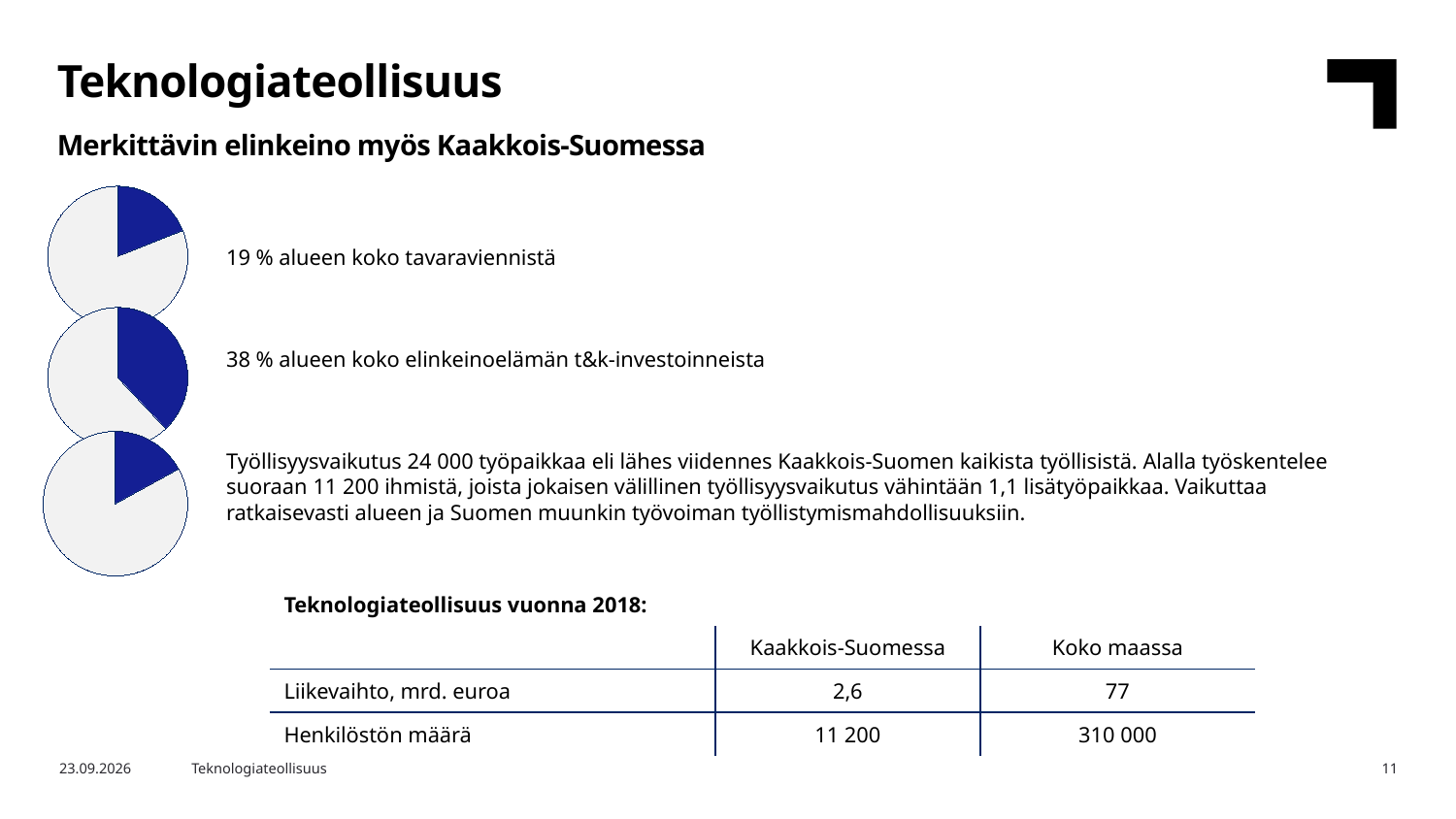
In the top pie chart, what share does the highlighted (blue) slice represent? 19 % What kind of chart are the three charts on the left side of the slide? Pie chart Is the highlighted slice in the bottom pie chart greater or less than half of the pie? less What is the difference in percentage points between the highlighted shares of the middle pie chart and the top pie chart? 19 percentage points How many pie charts are shown on the slide? 3 What does the middle pie chart's highlighted share refer to? Alueen koko elinkeinoelämän t&k-investoinnit (the region's business R&D investments) Which pie chart has the larger highlighted slice, the top one or the middle one? The middle one What does the top pie chart's highlighted share refer to? Alueen koko tavaravienti (the region's total goods exports) In the middle pie chart, what share does the highlighted (blue) slice represent? 38 % Which of the three pie charts has the largest highlighted slice? The middle one (38 %)